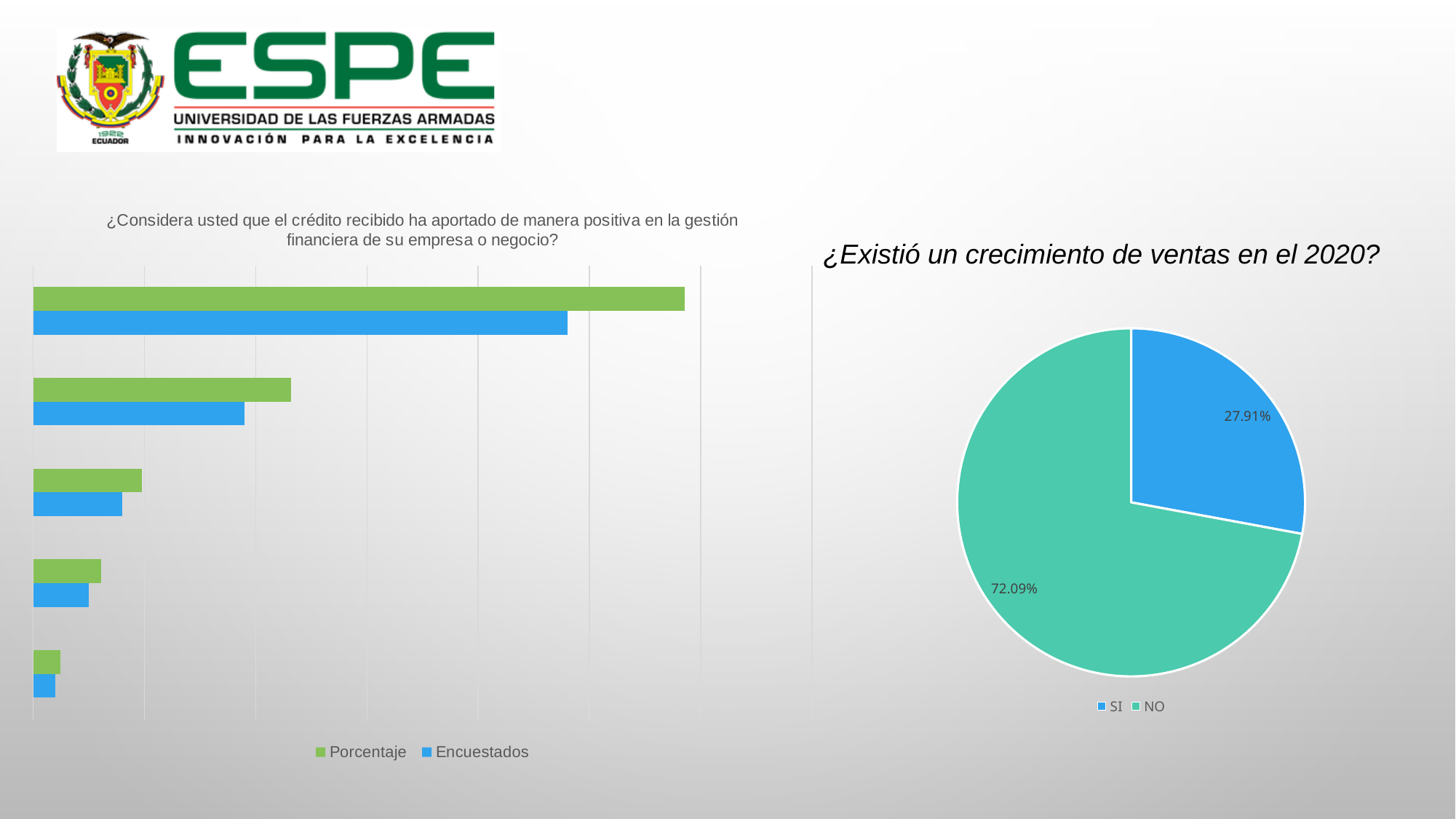
What kind of chart is the chart on the right of the slide? pie chart How many slices does the pie chart on the right have? 2 In the pie chart on the right, which slice is the smallest? SI In the pie chart on the right, what is the difference between the NO share and the SI share? 44.18% What kind of chart is the chart on the left of the slide? bar chart What are the two series named in the legend of the bar chart on the left? Porcentaje and Encuestados In the pie chart on the right, which slice is the largest? NO In the pie chart titled "¿Existió un crecimiento de ventas en el 2020?", what share is labelled for NO? 72.09% How many groups of bars are plotted in the bar chart on the left? 5 How many series does the legend of the bar chart on the left list? 2 In the pie chart titled "¿Existió un crecimiento de ventas en el 2020?", what share is labelled for SI? 27.91% In the pie chart on the right, is the share for SI larger or smaller than the share for NO? smaller